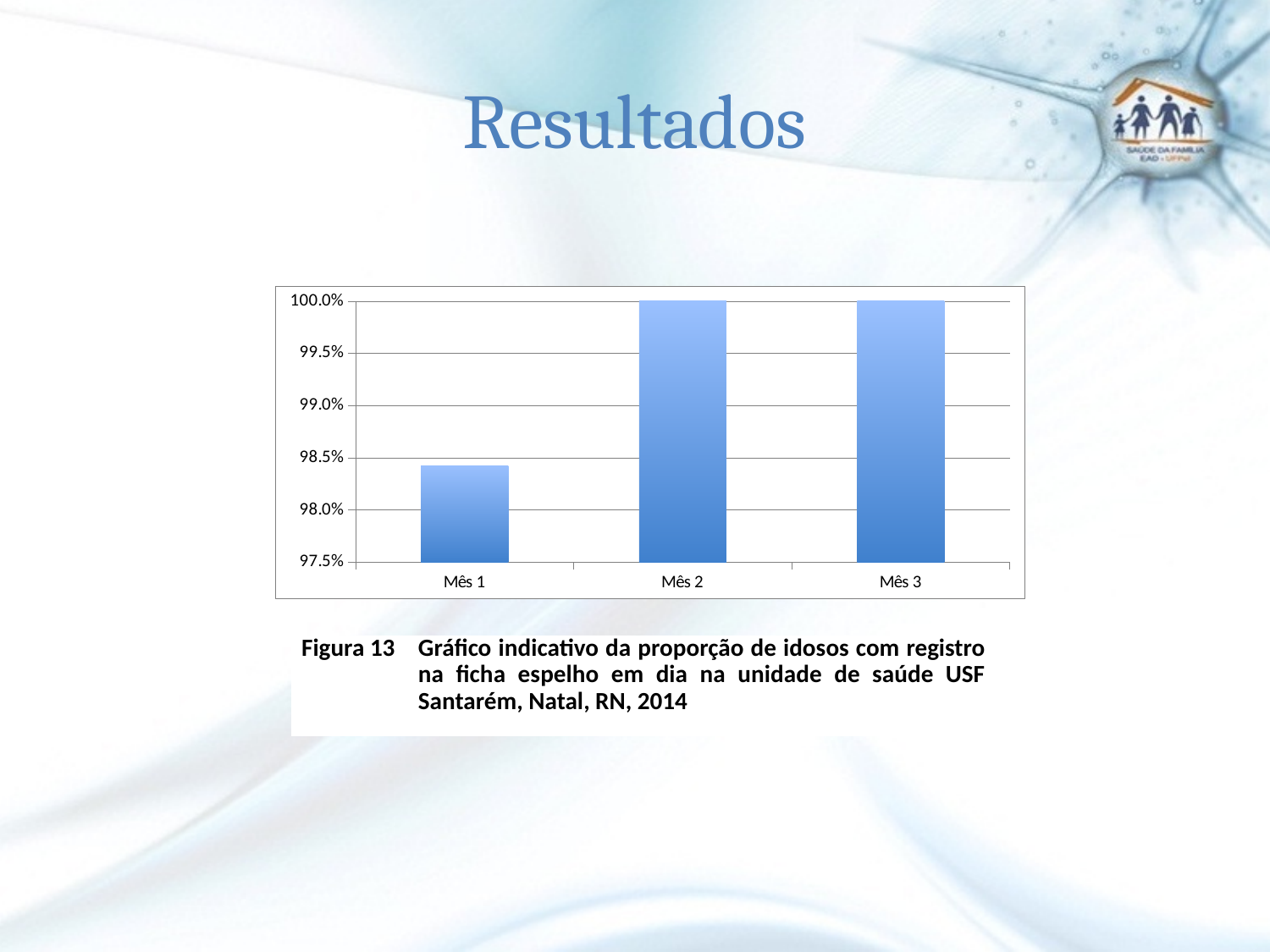
Which is larger, the value for Mês 1 or the value for Mês 2? Mês 2 Which is larger, the value for Mês 3 or the value for Mês 1? Mês 3 What is the lowest value shown on the y axis of the chart? 97.5% Is the value for Mês 1 greater or less than 98.5%? less Which category has the lowest value? Mês 1 Does the value rise or fall from Mês 1 to Mês 2? rise What is the figure number given in the caption below the chart? Figura 13 What kind of chart is shown on the slide? bar chart Is the value for Mês 1 greater or less than 98.0%? greater What is the value for Mês 2? 100.0% What is the value for Mês 3? 100.0% How many categories are shown on the x axis of the chart? 3